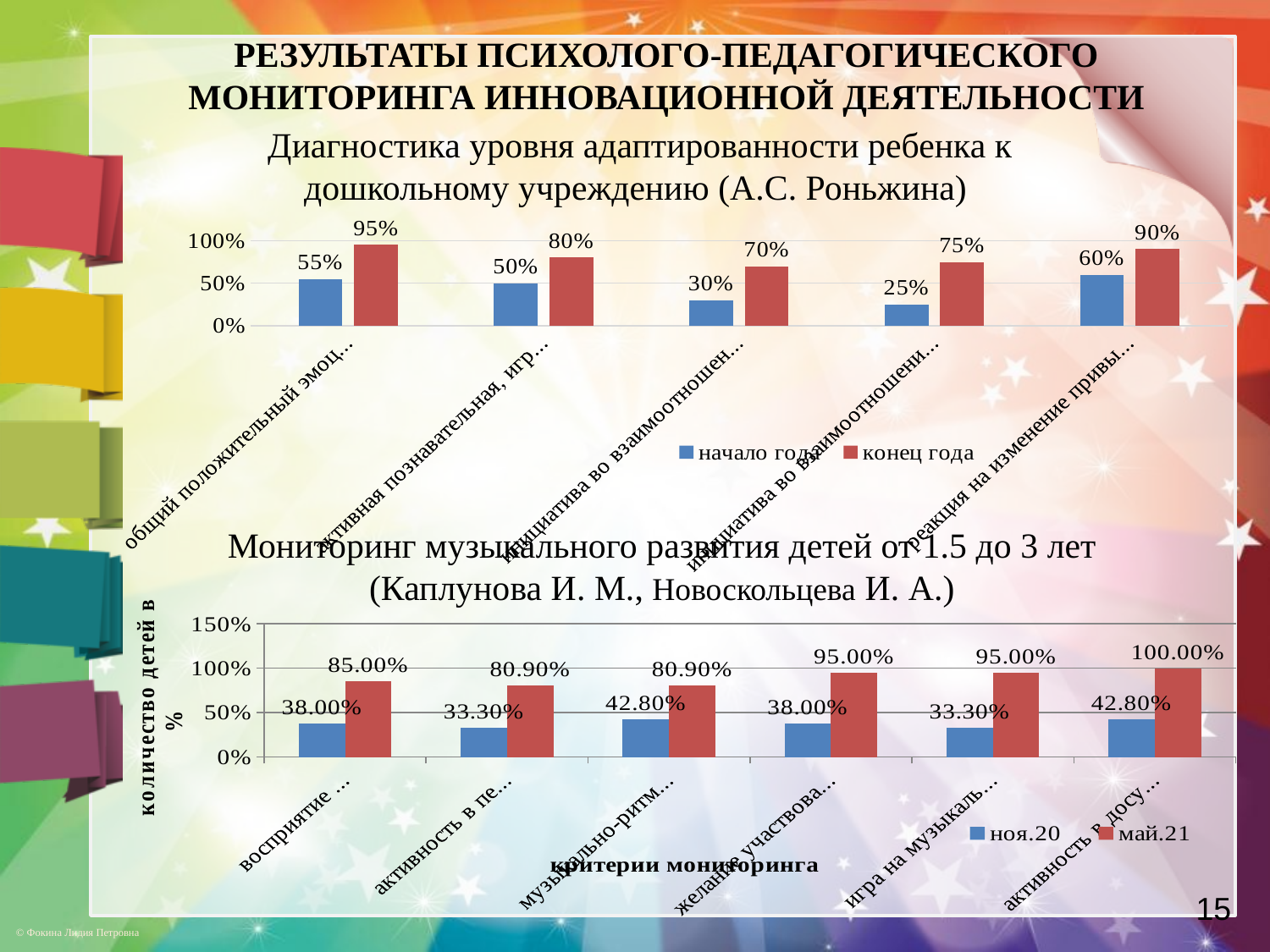
In the top chart (Диагностика уровня адаптированности), what is the value of the 'конец года' series for the first category? 95% In the bottom chart (Мониторинг музыкального развития), what is the 'ноя.20' value for the second category? 33.30% In the top chart (Диагностика уровня адаптированности), what is the difference between the 'конец года' and 'начало года' values for the third category? 40% In the top chart (Диагностика уровня адаптированности), how many series does the legend list? 2 In the top chart (Диагностика уровня адаптированности), which category has the lowest 'начало года' value? the fourth category (25%) What type of chart is the bottom chart (Мониторинг музыкального развития)? bar chart In the bottom chart (Мониторинг музыкального развития), what is the difference between the 'май.21' and 'ноя.20' values for the first category? 47.00% In the top chart (Диагностика уровня адаптированности), how many categories are plotted? 5 In the bottom chart (Мониторинг музыкального развития), how many categories are plotted? 6 In the bottom chart (Мониторинг музыкального развития), what is the 'май.21' value for the last category? 100.00% In the top chart (Диагностика уровня адаптированности), what is the value of the 'начало года' series for the fourth category? 25% In the bottom chart (Мониторинг музыкального развития), which category has the highest 'май.21' value? the last (sixth) category (100.00%)